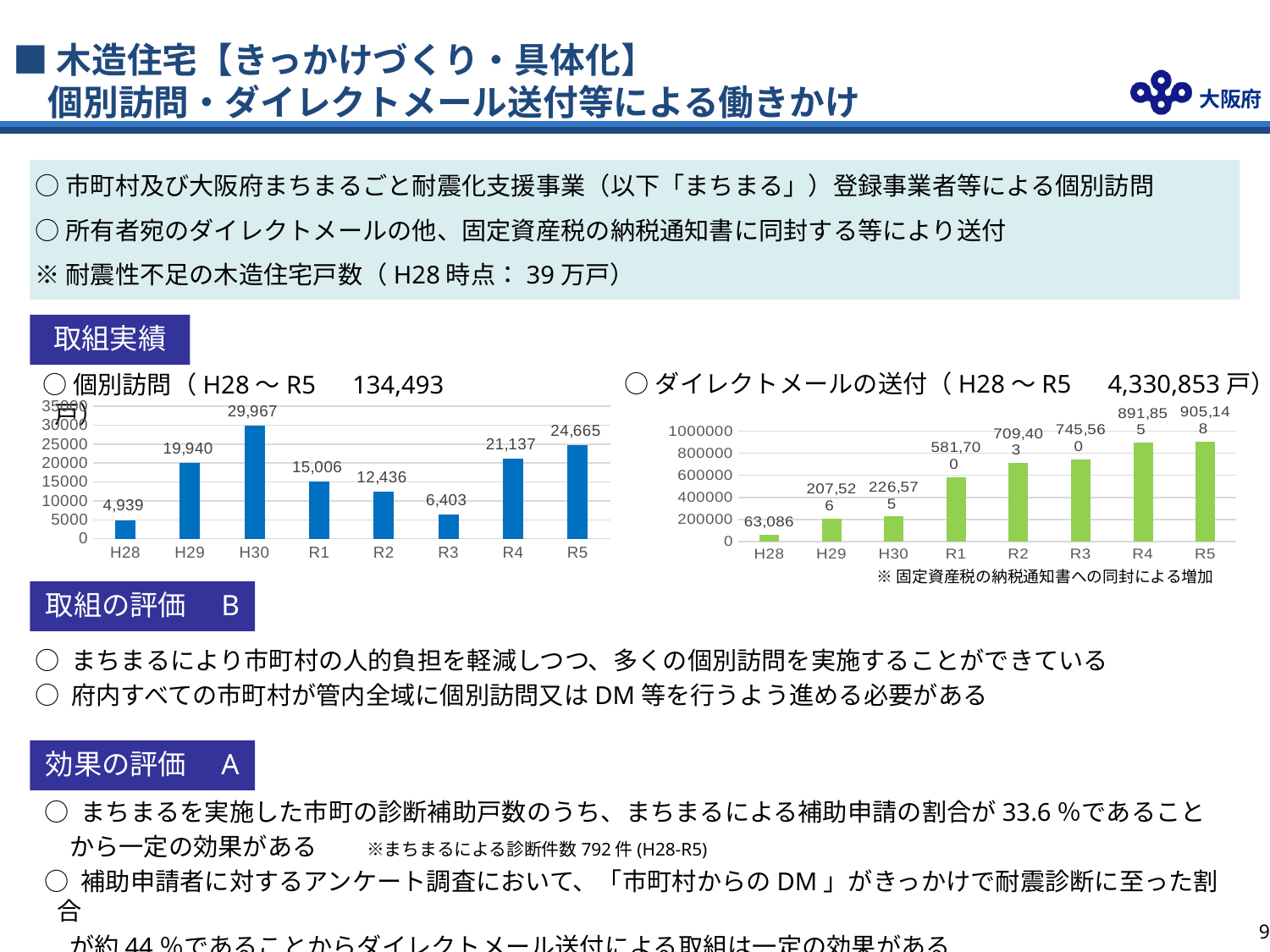
In the left chart (個別訪問), what is the value for H30? 29,967 In the left chart (個別訪問), how many years are plotted? 8 In the left chart (個別訪問), which year has the highest value? H30 In the right chart (ダイレクトメールの送付), do the values rise or fall from H28 to R5? rise In the right chart (ダイレクトメールの送付), what is the value for R5? 905,148 In the right chart (ダイレクトメールの送付), is the value for R1 greater or less than 400000? greater In the left chart (個別訪問), which is larger, the value for H29 or the value for R1? H29 In the right chart (ダイレクトメールの送付), what is the value for H28? 63,086 In the left chart (個別訪問), which year has the lowest value? H28 In the left chart (個別訪問), what is the value for R3? 6,403 What kind of chart is the right chart (ダイレクトメールの送付)? bar chart In the left chart (個別訪問), what is the difference between the values for R5 and R4? 3,528